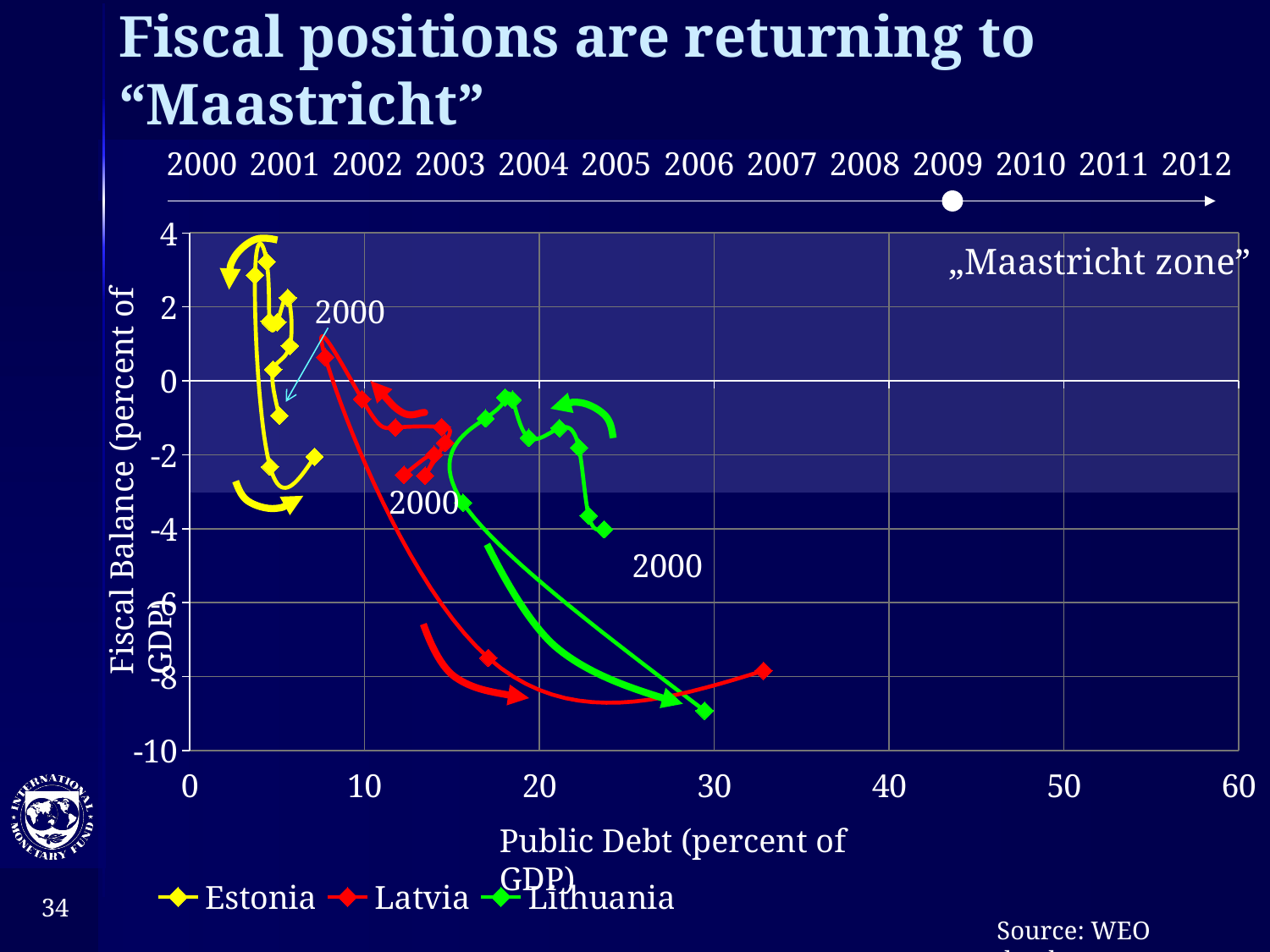
Which countries are listed in the legend? Estonia, Latvia, Lithuania Which series reaches the highest public debt on the chart? Latvia Is the highest fiscal balance reached by Estonia greater or less than 2? greater Is the highest public debt reached by Latvia greater or less than 30? greater Is the lowest fiscal balance reached by Lithuania greater or less than -8? less How many years are labelled on the timeline above the chart? 13 Which series reaches a higher public debt, Latvia or Estonia? Latvia How many series does the legend list? 3 What is the highest value shown on the y axis? 4 What is the label of the x axis? Public Debt (percent of GDP) Which series reaches the highest fiscal balance on the chart? Estonia